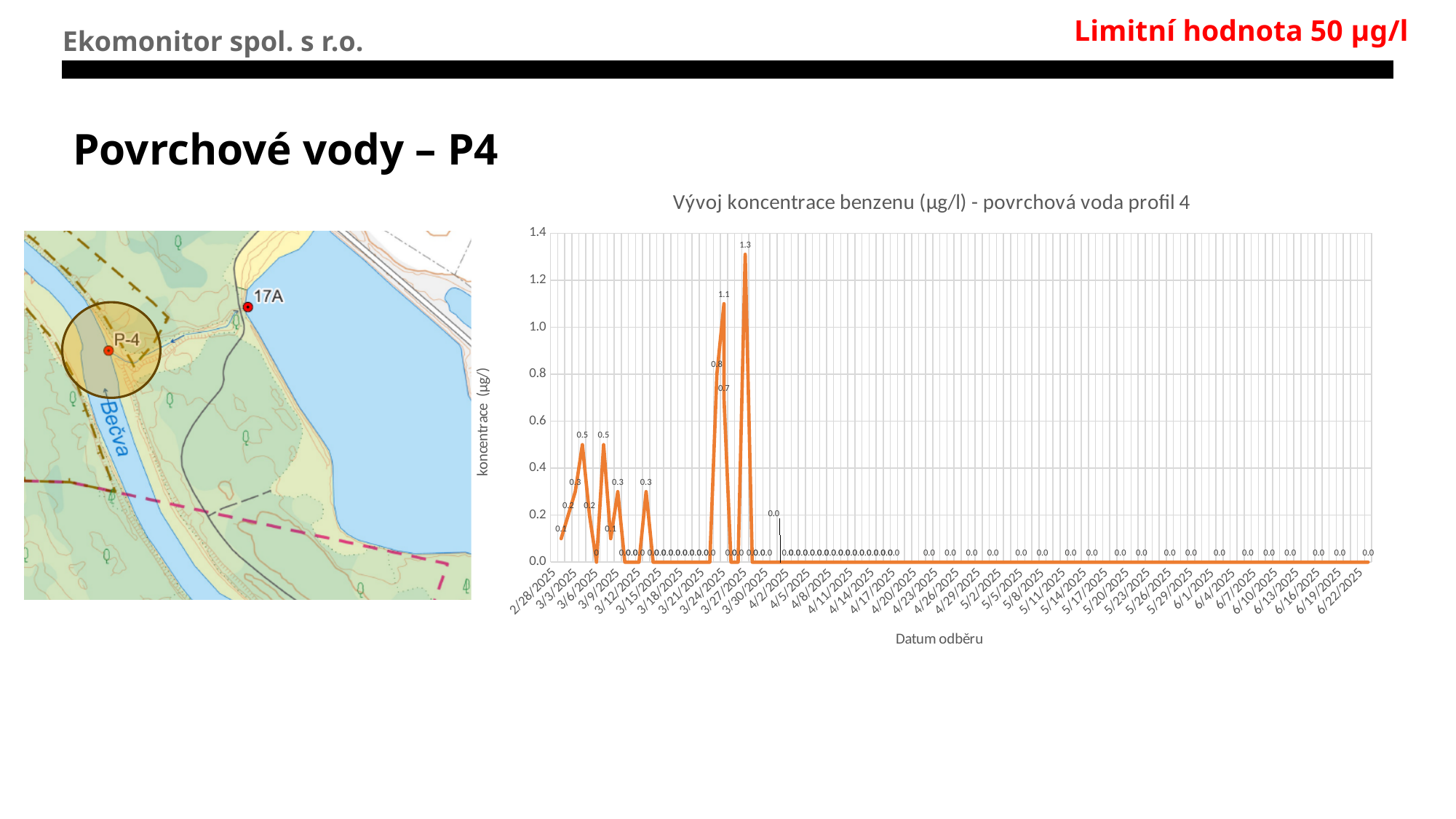
What kind of chart is shown on the slide? line chart What is the maximum value shown on the y axis? 1.4 What is the highest benzene concentration value labelled on the chart? 1.3 What is the concentration value labelled at the first date, 2/28/2025? 0.1 Do the concentration values overall rise or fall from the start of the x axis to the end? fall What is the lowest value labelled on the chart? 0.0 What is the title of the chart on the slide? Vývoj koncentrace benzenu (µg/l) - povrchová voda profil 4 What is the concentration value labelled at the last date, 6/22/2025? 0.0 What is the label of the x axis? Datum odběru What is the difference between the two highest labelled peaks, 1.3 and 1.1? 0.2 Is the highest peak on the chart greater or less than 1.0? greater Which is larger, the peak labelled 1.3 or the peak labelled 1.1? 1.3